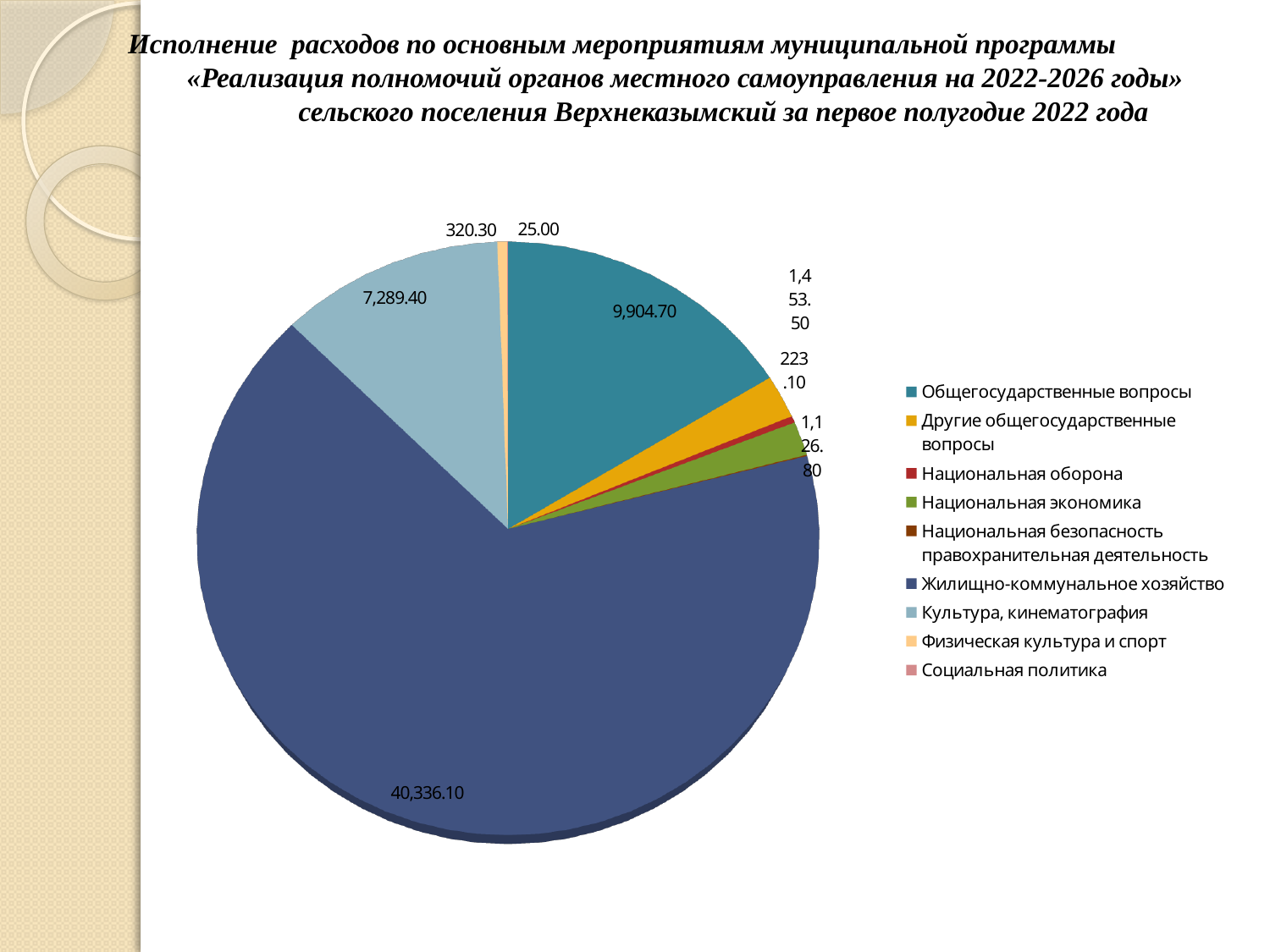
What is the difference between Физическая культура и спорт and Социальная политика? 295.30 What is the value for Физическая культура и спорт? 320.30 What is the difference between Общегосударственные вопросы and Культура, кинематография? 2,615.30 What is the value for Социальная политика? 25.00 Which colour represents Жилищно-коммунальное хозяйство in the legend? dark blue Which category has the largest slice of the pie? Жилищно-коммунальное хозяйство What is the value for Жилищно-коммунальное хозяйство? 40,336.10 Which is larger, Общегосударственные вопросы or Культура, кинематография? Общегосударственные вопросы What is the value for Культура, кинематография? 7,289.40 How many categories does the legend list? 9 What is the value for Общегосударственные вопросы? 9,904.70 What kind of chart is shown on the slide? pie chart